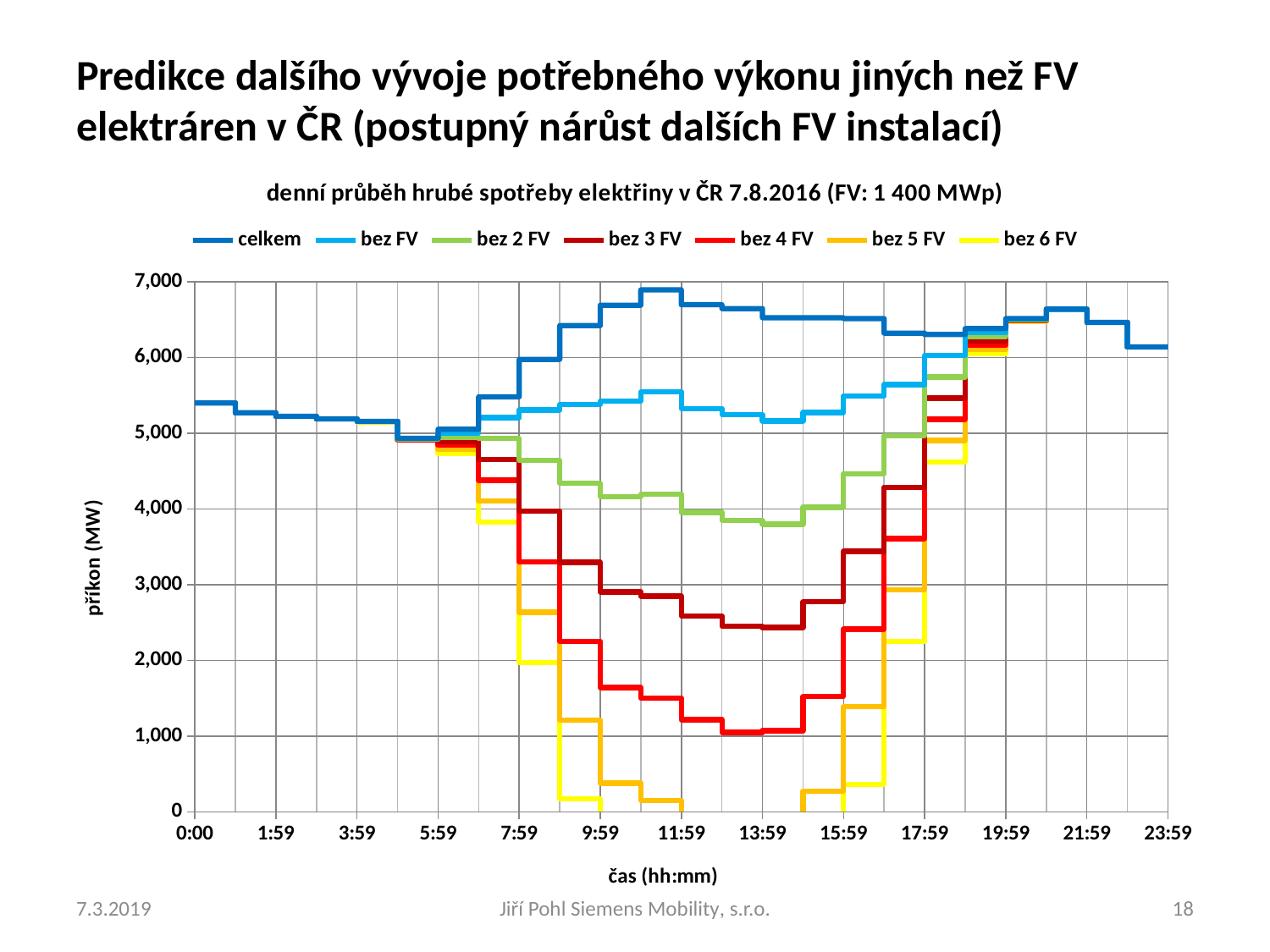
How many series does the legend list? 7 Is the value of the 'celkem' series at 11:59 greater or less than 7,000? less Is the value of the 'bez 2 FV' series at 13:59 greater or less than 4,000? less Which series has the lowest value around 12:59? bez 6 FV What is the label of the vertical axis? příkon (MW) Is the value of the 'bez 3 FV' series at 12:59 greater or less than 2,000? greater What kind of chart is shown on the slide? line chart Does the 'celkem' series rise or fall between 0:00 and 5:59? fall What is the title of the chart? denní průběh hrubé spotřeby elektřiny v ČR 7.8.2016 (FV: 1 400 MWp) Which series has the highest values across the whole day? celkem